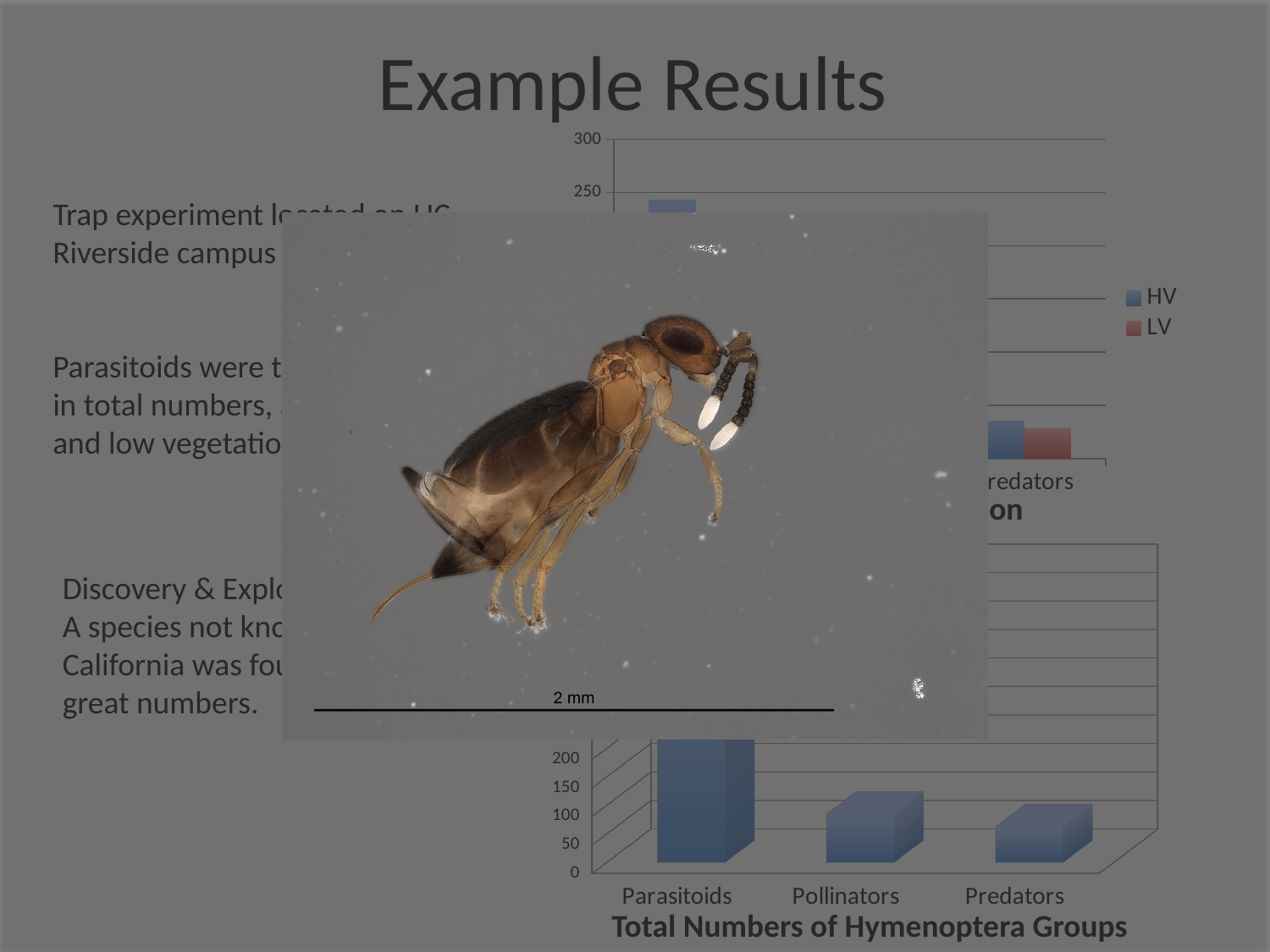
In the bottom chart, 'Total Numbers of Hymenoptera Groups', which category has the highest value? Parasitoids What is the title of the bottom chart? Total Numbers of Hymenoptera Groups What kind of chart is the top chart on the slide? bar chart What kind of chart is the bottom chart, 'Total Numbers of Hymenoptera Groups'? bar chart In the bottom chart, 'Total Numbers of Hymenoptera Groups', is the value for Pollinators greater or less than 50? greater How many categories are shown on the x axis of the bottom chart, 'Total Numbers of Hymenoptera Groups'? 3 How many series does the legend of the top chart list? 2 In the bottom chart, 'Total Numbers of Hymenoptera Groups', which is larger, the value for Pollinators or the value for Predators? Pollinators In the bottom chart, 'Total Numbers of Hymenoptera Groups', which category has the lowest value? Predators What are the two series named in the legend of the top chart? HV and LV In the bottom chart, 'Total Numbers of Hymenoptera Groups', is the value for Parasitoids greater or less than 150? greater